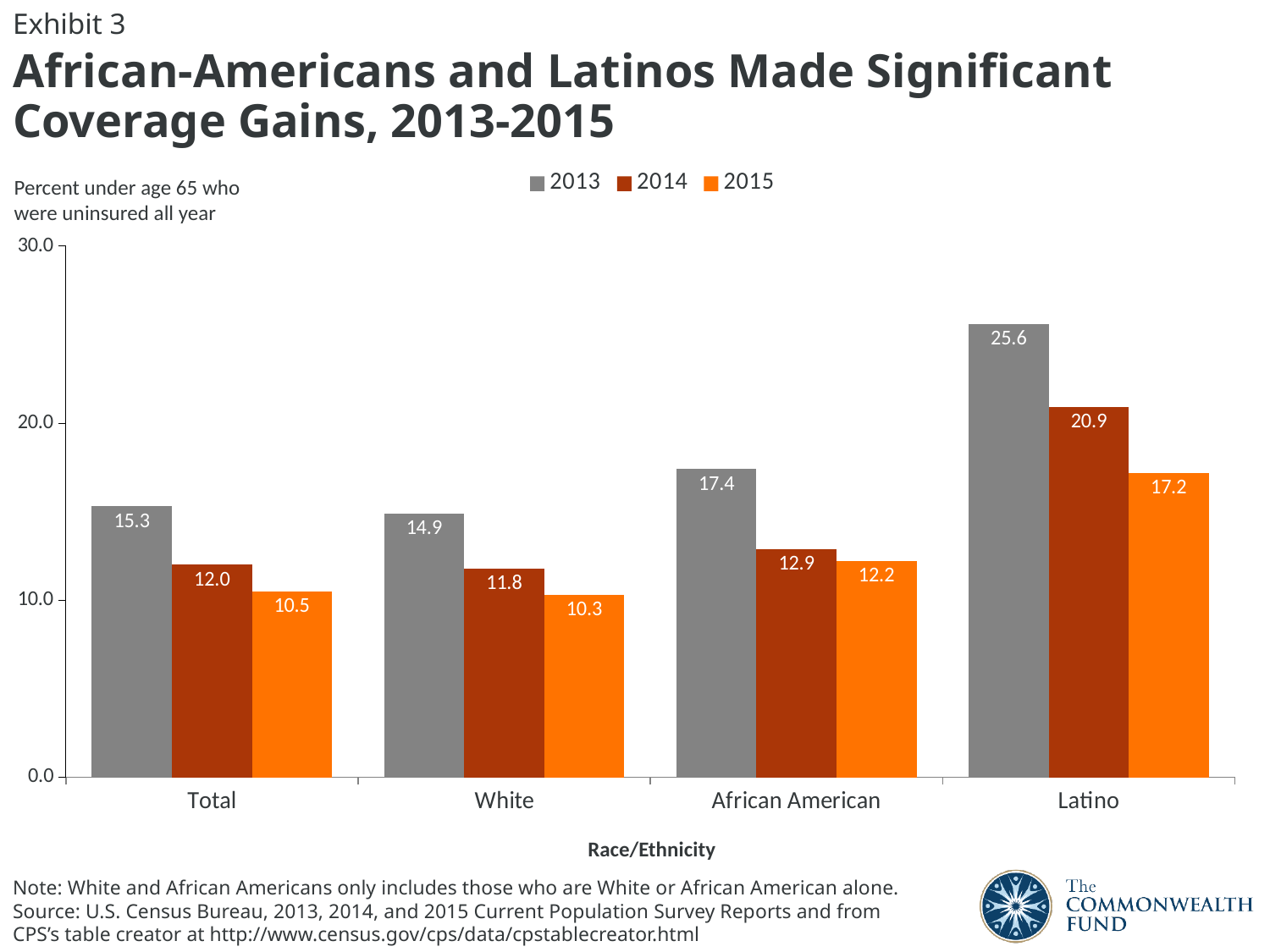
What was the percent uninsured all year for African Americans in 2015? 12.2 What is the difference between the 2013 and 2014 values for African Americans? 4.5 Is the 2014 value for Latinos greater or less than 20.0? greater Which race/ethnicity group had the highest percent uninsured in 2015? Latino How many race/ethnicity categories are shown on the x axis? 4 Which race/ethnicity group had the lowest percent uninsured in 2013? White What was the percent uninsured all year for Whites in 2014? 11.8 By how many percentage points did the uninsured rate for Latinos fall from 2013 to 2015? 8.4 What was the percent uninsured all year for Latinos in 2013? 25.6 What kind of chart is shown on the slide? Bar chart How many series does the legend list? 3 Which is larger: the 2015 value for Total or the 2015 value for African American? African American